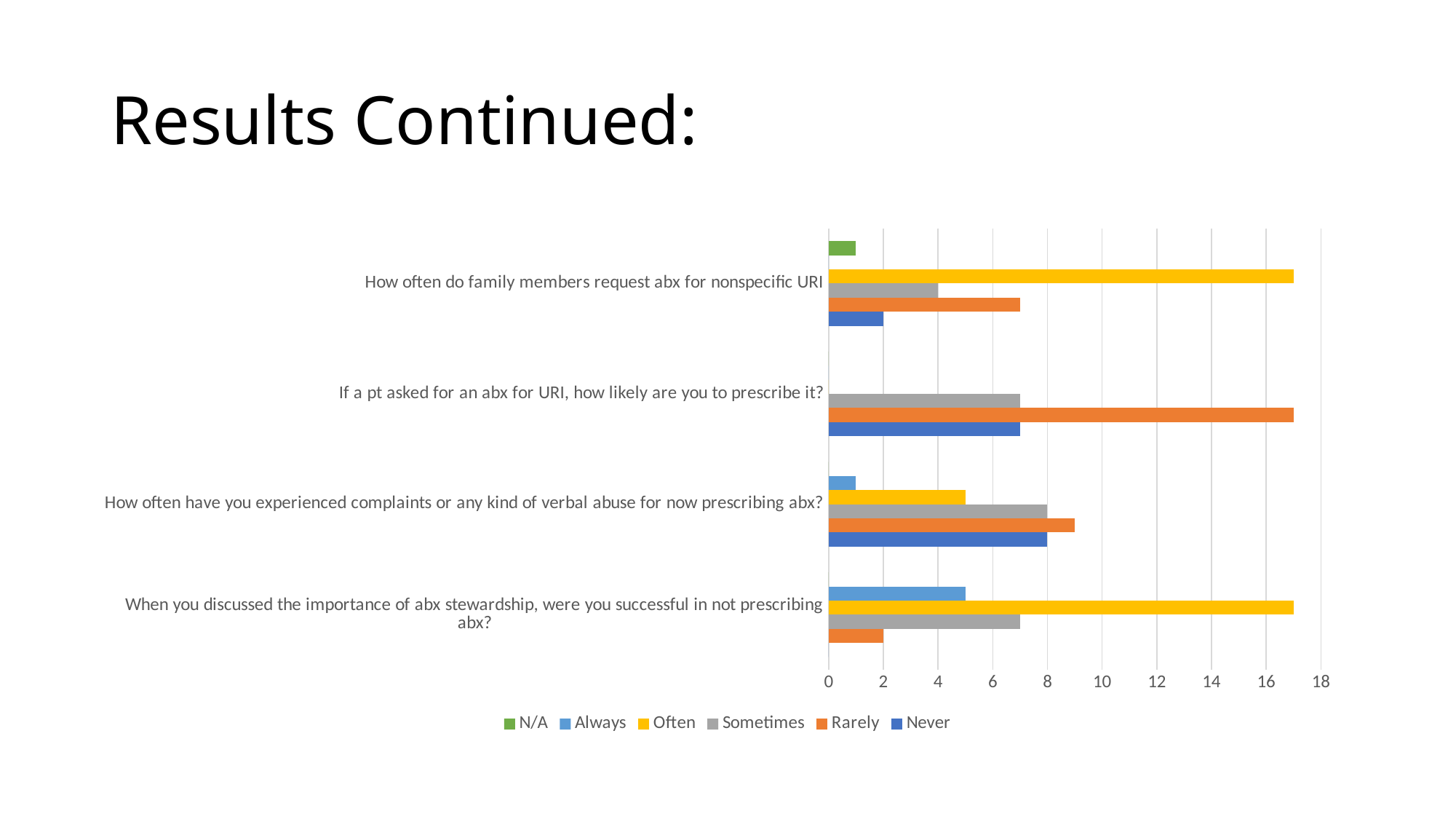
Is the value for Rarely for "If a pt asked for an abx for URI, how likely are you to prescribe it?" greater or less than 16? greater How many series does the legend list? 6 For "How often do family members request abx for nonspecific URI", which is larger: Often or Rarely? Often What is the value for Never for "How often do family members request abx for nonspecific URI"? 2 Is the value for Often for "How often do family members request abx for nonspecific URI" greater or less than 16? greater What kind of chart is shown on the slide? bar chart What is the value for Sometimes for "How often do family members request abx for nonspecific URI"? 4 What is the value for Rarely for "When you discussed the importance of abx stewardship, were you successful in not prescribing abx?"? 2 Is the value for Always for "When you discussed the importance of abx stewardship, were you successful in not prescribing abx?" greater or less than 4? greater For "How often do family members request abx for nonspecific URI", what is the difference between the Sometimes and Never values? 2 How many survey questions (categories) are plotted on the chart? 4